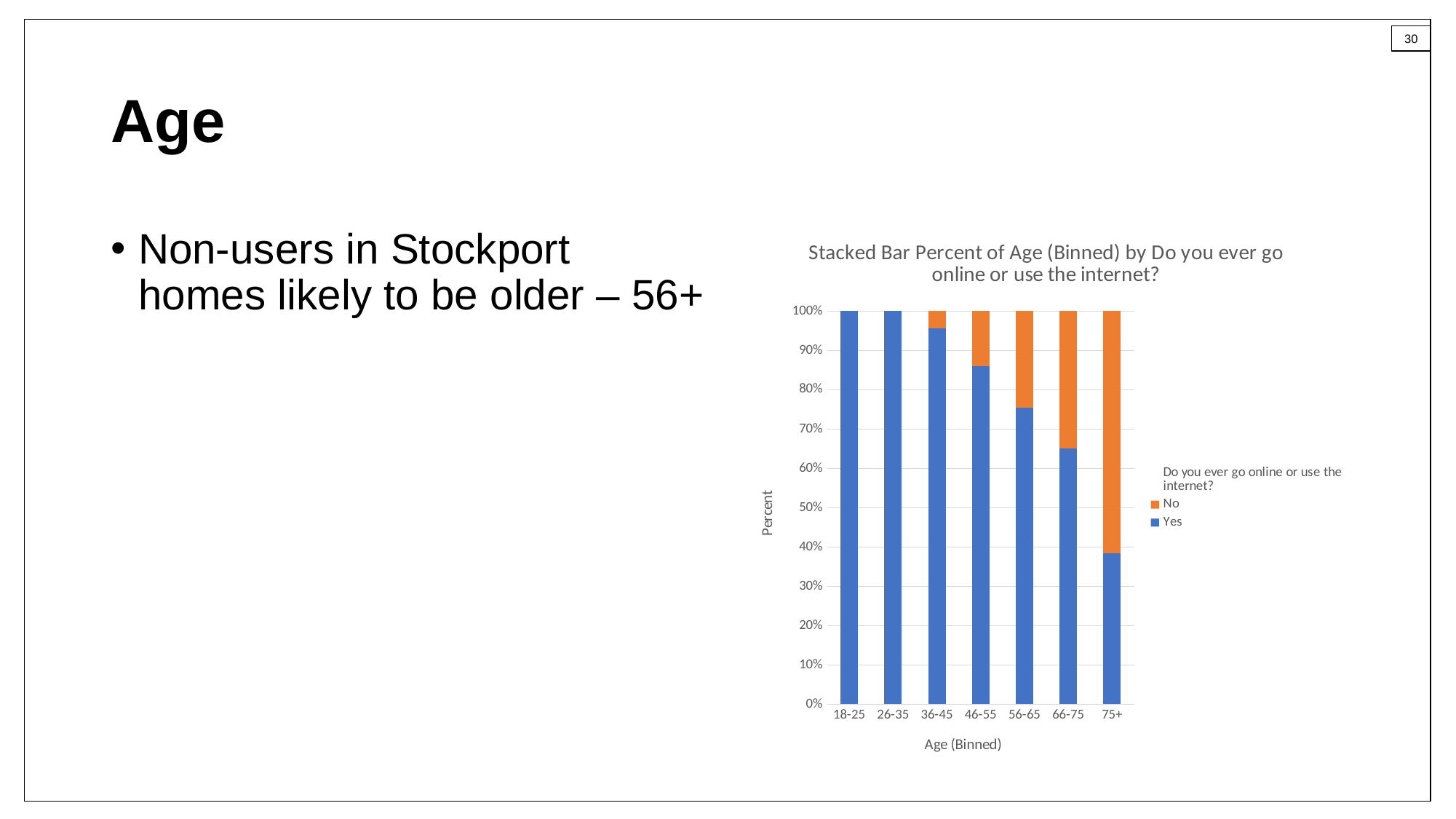
Is the 'Yes' value for the 46-55 age group greater or less than 90%? less What is the 'Yes' percentage for the 18-25 age group? 100% How many series does the legend list? 2 Does the 'Yes' share rise or fall as age increases along the x axis? Falls Which has a larger 'Yes' share, the 66-75 group or the 36-45 group? 36-45 Which age group has the smallest 'Yes' share? 75+ What is the label of the y axis? Percent How many age categories are shown on the x axis? 7 Is the 'Yes' value for the 56-65 age group greater or less than 70%? greater What kind of chart is shown on the slide? Stacked bar chart Is the 'Yes' value for the 75+ age group greater or less than 40%? less Which age group has the largest 'No' share? 75+